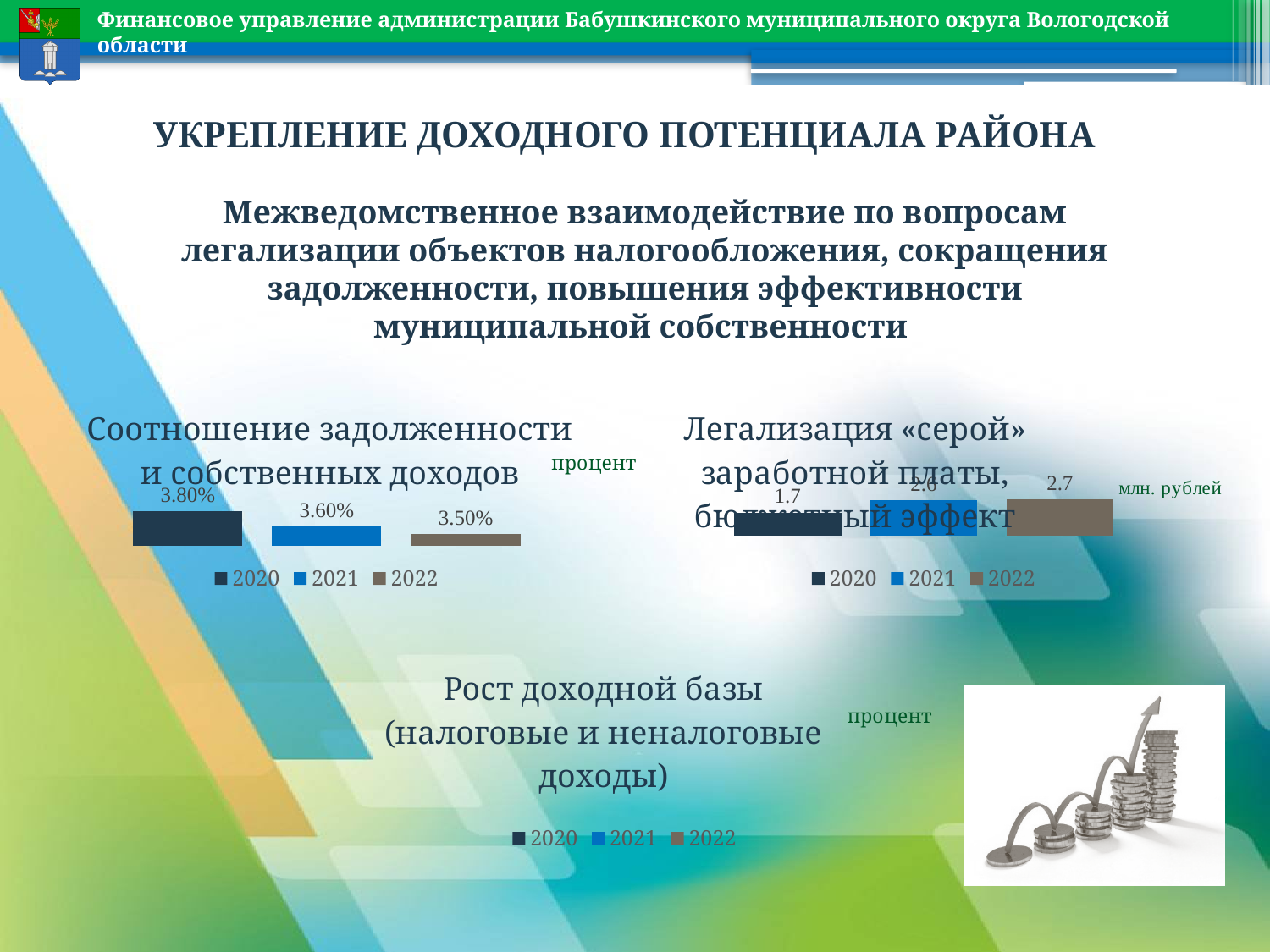
In the chart 'Соотношение задолженности и собственных доходов', what is the value for 2022? 3.50% In the chart 'Легализация «серой» заработной платы, бюджетный эффект', which year has the lowest value? 2020 In the chart 'Легализация «серой» заработной платы, бюджетный эффект', what is the value for 2022? 2.7 How many series does the legend of the chart 'Рост доходной базы (налоговые и неналоговые доходы)' list? 3 In the chart 'Легализация «серой» заработной платы, бюджетный эффект', what is the value for 2020? 1.7 In the chart 'Соотношение задолженности и собственных доходов', do the values rise or fall from 2020 to 2022? fall In the chart 'Соотношение задолженности и собственных доходов', which year has the lowest value? 2022 What kind of chart is 'Соотношение задолженности и собственных доходов'? bar chart In the chart 'Легализация «серой» заработной платы, бюджетный эффект', what is the difference between the 2022 and 2020 values? 1.0 In the chart 'Соотношение задолженности и собственных доходов', which year has the highest value? 2020 In the chart 'Легализация «серой» заработной платы, бюджетный эффект', what unit is shown next to the chart? млн. рублей In the chart 'Соотношение задолженности и собственных доходов', what is the value for 2020? 3.80%